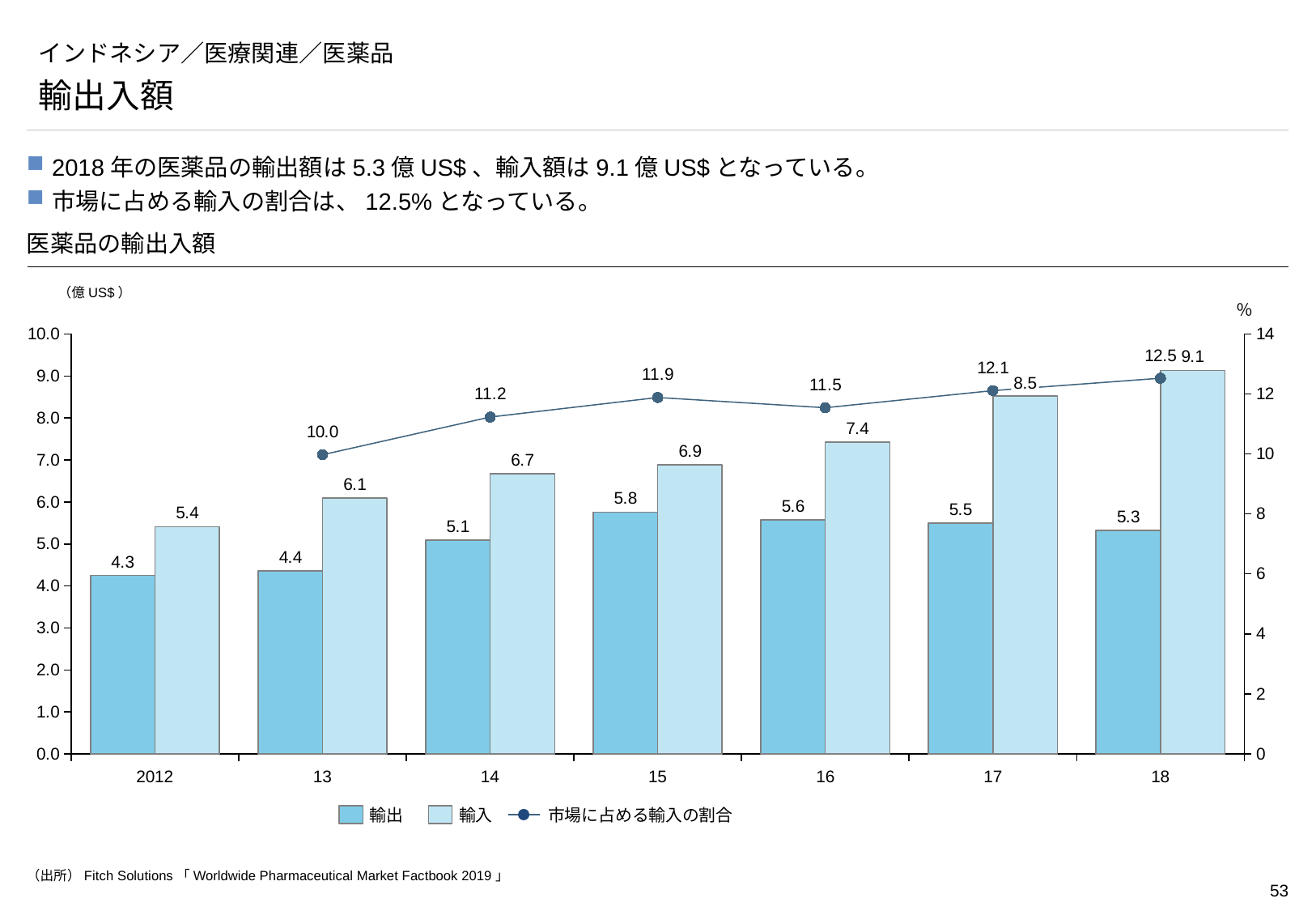
What is the 市場に占める輸入の割合 value for 15? 11.9 What is the unit shown for the left axis? 億US$ Which year has the lowest 輸入 (import) value? 2012 What kind of chart is this? Combined bar and line chart What is the 輸入 (import) value for 18? 9.1 What is the difference between the 輸入 and 輸出 values for 18? 3.8 What is the 輸出 (export) value for 2012? 4.3 Which is larger in 16, the 輸出 value or the 輸入 value? 輸入 How many series does the legend list? 3 Do the 輸入 (import) values rise or fall from 2012 to 18? Rise How many years are shown on the x axis? 7 Which year has the highest 輸出 (export) value? 15